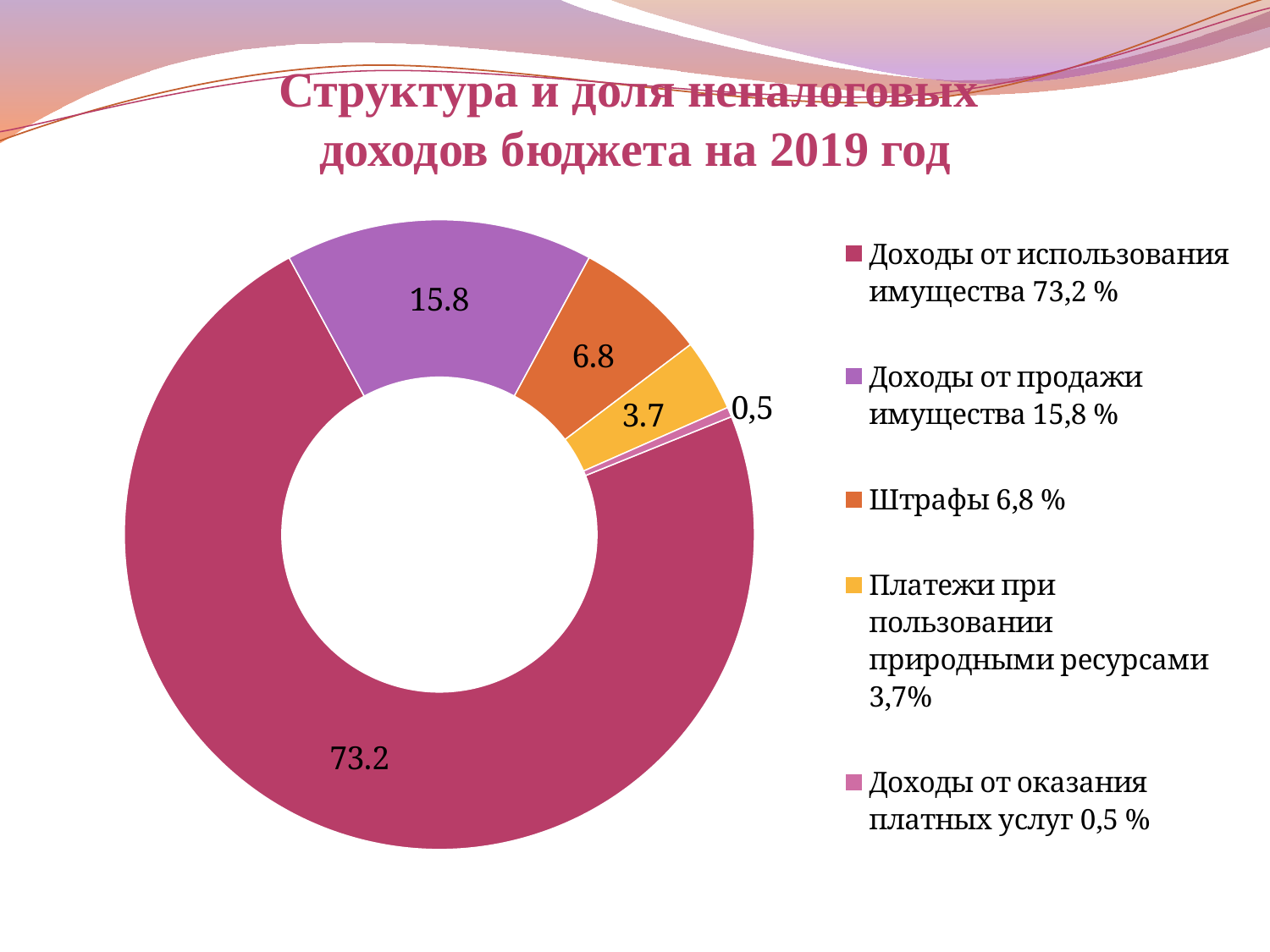
What value is shown for the slice "Доходы от использования имущества"? 73.2 Which category has the smallest slice? Доходы от оказания платных услуг Which category has the largest slice? Доходы от использования имущества What value is shown for the slice "Платежи при пользовании природными ресурсами"? 3.7 What value is shown for the slice "Штрафы"? 6.8 What is the difference between the values for "Доходы от продажи имущества" and "Штрафы"? 9 Which is larger, the slice for "Штрафы" or the slice for "Платежи при пользовании природными ресурсами"? Штрафы What is the title of the chart on the slide? Структура и доля неналоговых доходов бюджета на 2019 год What is the difference between the values for "Доходы от использования имущества" and "Доходы от продажи имущества"? 57.4 What kind of chart is shown on the slide? doughnut chart How many slices does the chart have? 5 What value is shown for the slice "Доходы от продажи имущества"? 15.8